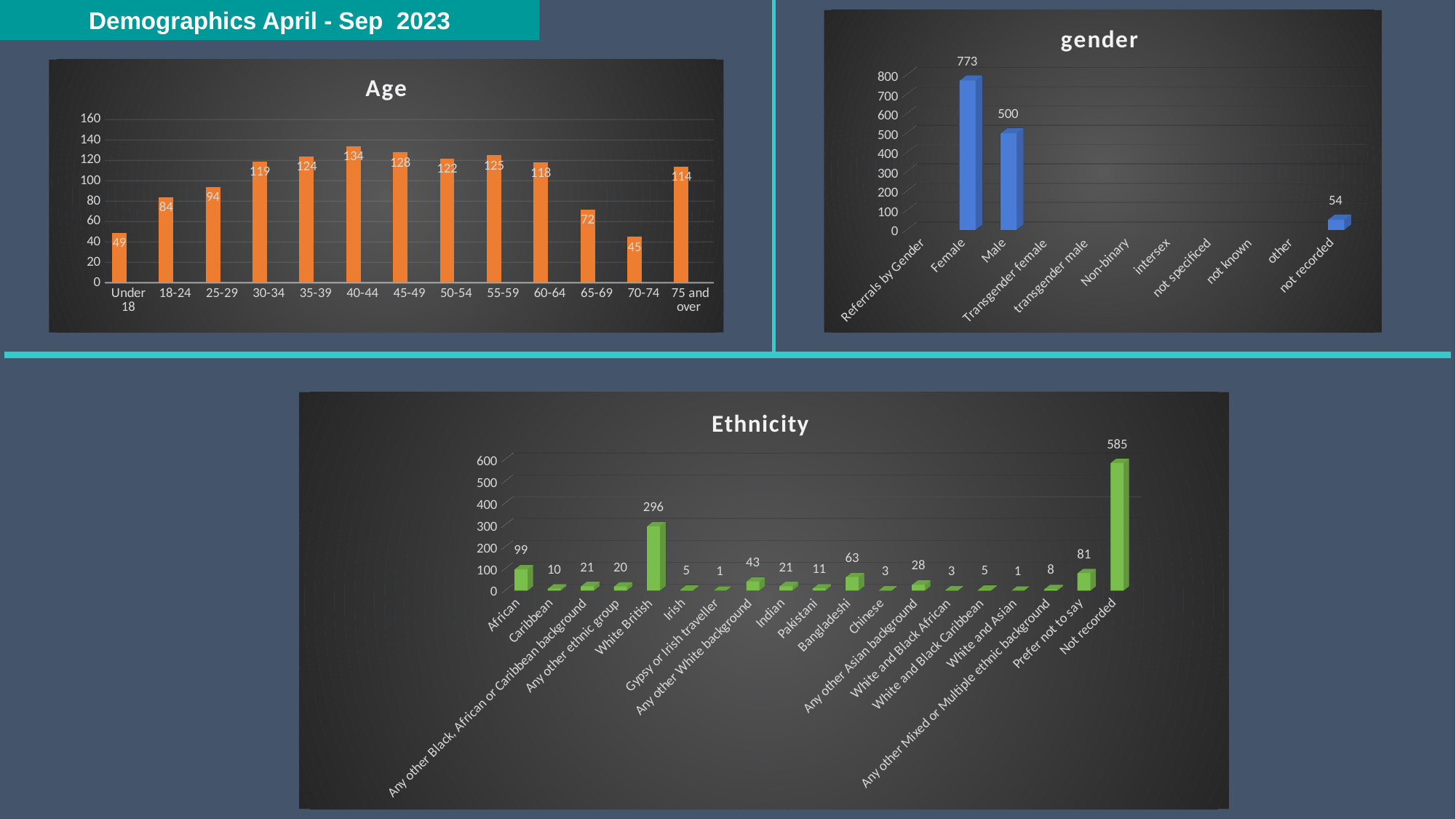
In the Ethnicity chart, what is the value for Prefer not to say? 81 In the Ethnicity chart, what is the value for White British? 296 In the Age chart, what is the value for the 40-44 age group? 134 In the Age chart, what is the difference between the values for 18-24 and Under 18? 35 In the Age chart, how many age groups are shown on the x axis? 13 In the Ethnicity chart, which category has the highest value? Not recorded In the gender chart, what is the value for Female? 773 In the gender chart, what is the value for not recorded? 54 What kind of chart is the Ethnicity chart? bar chart In the gender chart, what is the difference between the Female and Male values? 273 In the Ethnicity chart, which is larger, the value for Bangladeshi or the value for Any other Asian background? Bangladeshi In the Age chart, which age group has the lowest value? 70-74